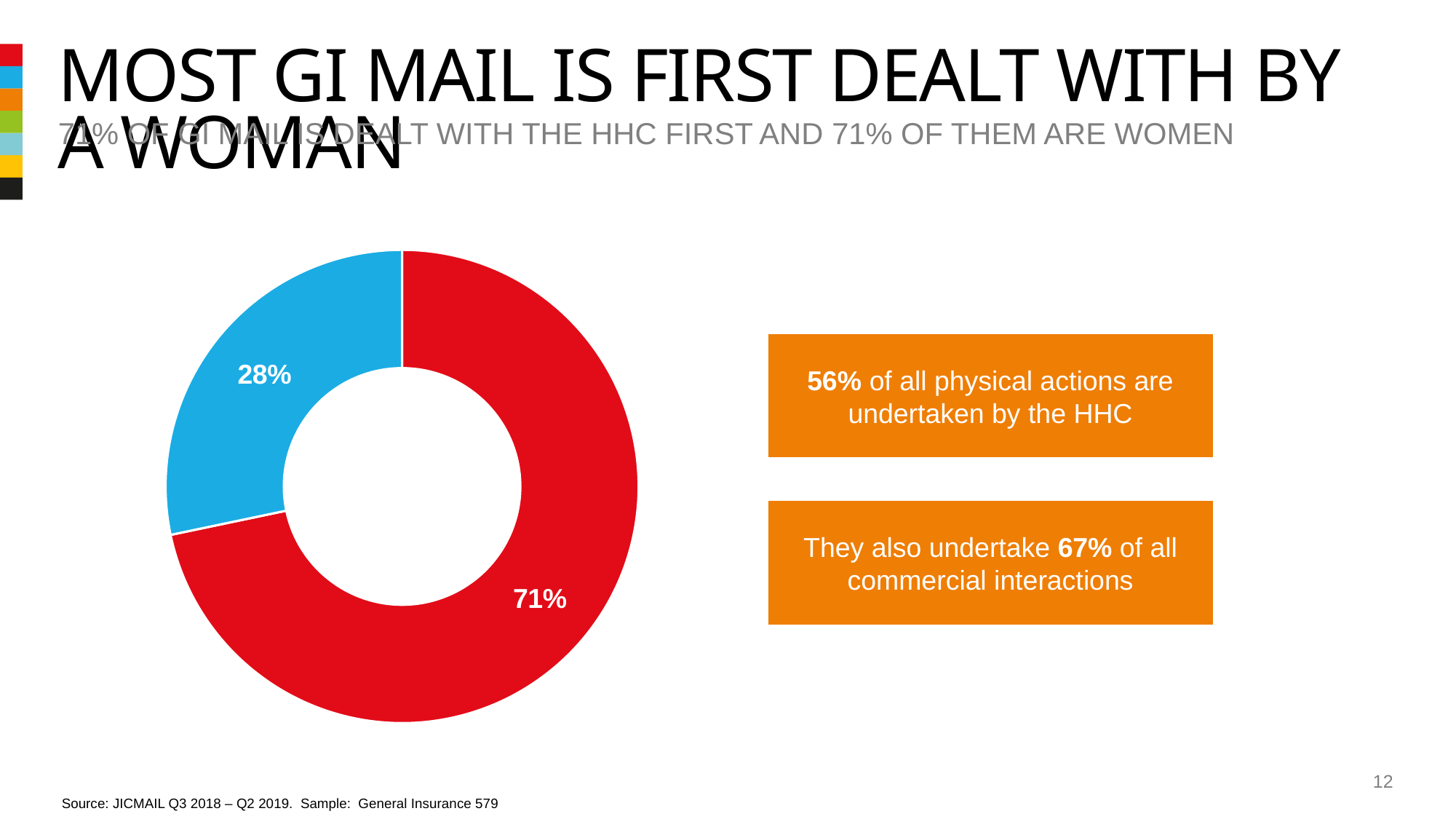
Is the value of the blue slice greater or less than 50%? less What value is shown on the blue slice of the donut chart? 28% What value is shown on the red slice of the donut chart? 71% What kind of chart is shown on the slide? Donut (pie) chart Which slice of the donut chart is the smallest? The blue slice (28%) How many slices does the donut chart have? 2 What share of the donut does the red slice represent? 71% What colour is the slice labelled 28%? Blue Which slice of the donut chart is the largest? The red slice (71%) What is the difference in percentage points between the red slice and the blue slice? 43 percentage points What is the title of the slide containing the donut chart? MOST GI MAIL IS FIRST DEALT WITH BY A WOMAN Which is larger, the red slice or the blue slice? The red slice